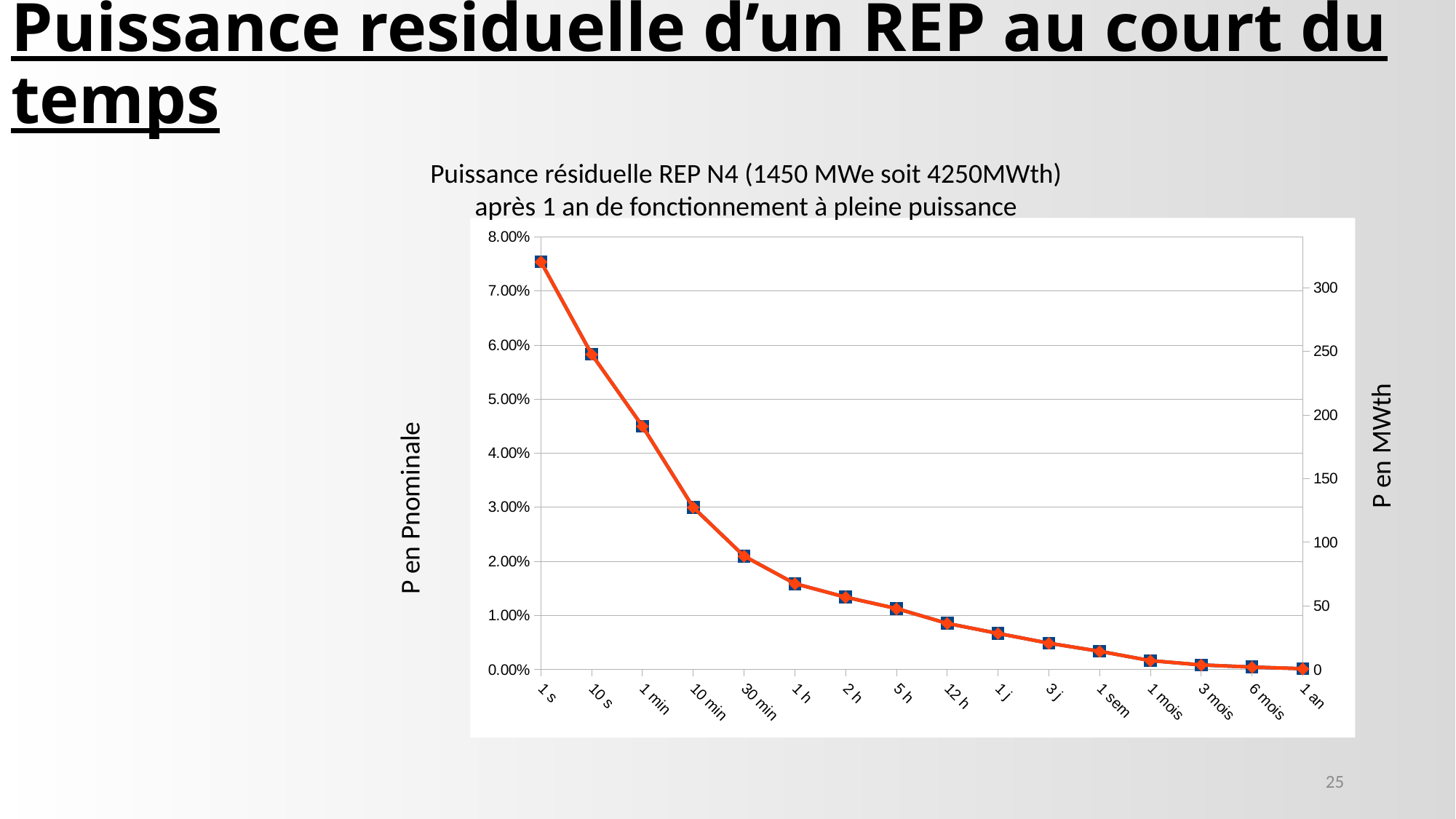
Is the value for 1 s greater or less than 7.00%? greater At which time point is the residual power lowest? 1 an Do the values rise or fall as time increases along the x axis? fall How many time points are plotted along the x axis? 16 What kind of chart is shown on the slide? line chart Is the value for 1 min greater or less than 4.00%? greater At which time point is the residual power highest? 1 s Is the value for 12 h greater or less than 1.00%? less Which is larger, the value for 1 min or the value for 1 h? 1 min What is the label of the right-hand vertical axis? P en MWth